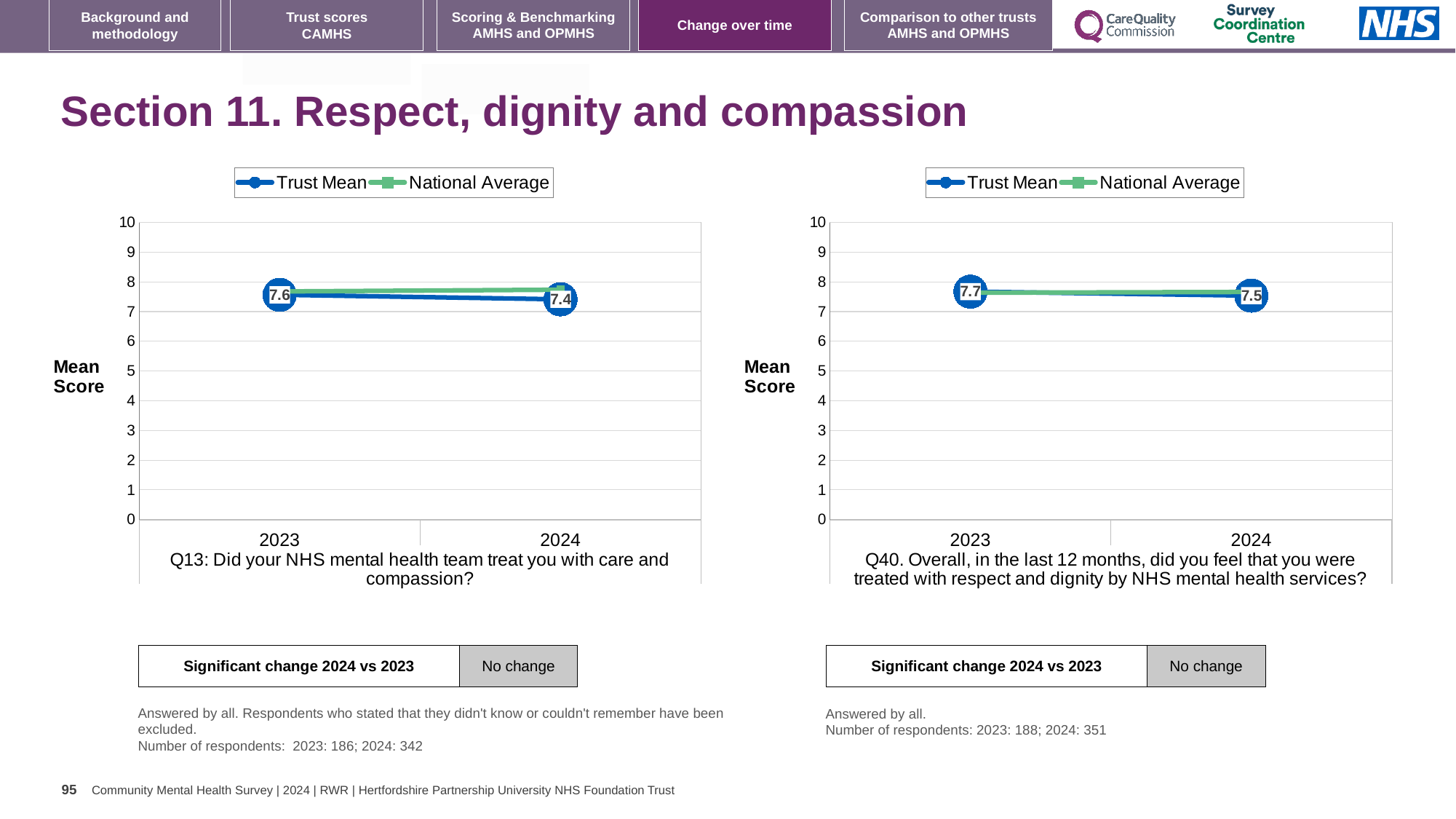
What type of chart is used on the left for Q13? line chart How many series does the legend of the right chart (Q40) list? 2 In the right chart (Q40), what is the Trust Mean score for 2024? 7.5 In the left chart (Q13), does the Trust Mean rise or fall from 2023 to 2024? fall In the right chart (Q40), which year has the higher Trust Mean, 2023 or 2024? 2023 In the left chart (Q13), what is the Trust Mean score for 2023? 7.6 In the right chart (Q40), what is the difference between the Trust Mean in 2023 and 2024? 0.2 How many years are shown on the x axis of the left chart (Q13)? 2 In the left chart (Q13), what is the Trust Mean score for 2024? 7.4 In the left chart (Q13), by how much did the Trust Mean change from 2023 to 2024? 0.2 In the right chart (Q40), what is the Trust Mean score for 2023? 7.7 In the right chart (Q40), is the National Average for 2024 greater or less than 7? greater